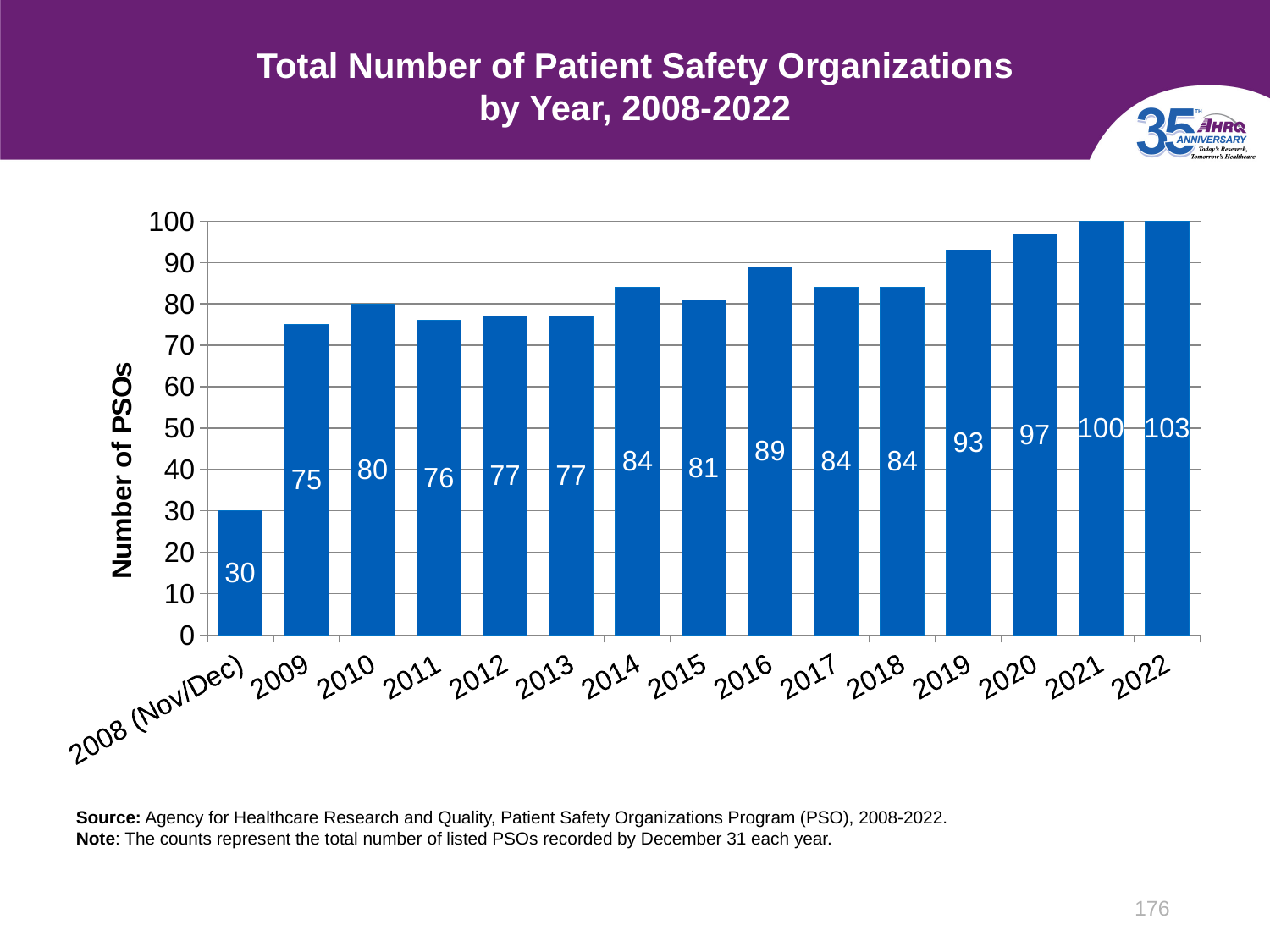
Which year has more PSOs, 2010 or 2011? 2010 What is the number of PSOs in 2022? 103 Do the values generally rise or fall from 2018 to 2022? Rise What is the number of PSOs in 2008 (Nov/Dec)? 30 What is the number of PSOs in 2016? 89 How many years (categories) are shown on the x axis? 15 What is the label of the y axis? Number of PSOs Which year has the highest number of PSOs? 2022 What is the difference in the number of PSOs between 2016 and 2015? 8 What kind of chart is shown on the slide? Bar chart What is the difference in the number of PSOs between 2022 and 2008 (Nov/Dec)? 73 Which year has the lowest number of PSOs? 2008 (Nov/Dec)